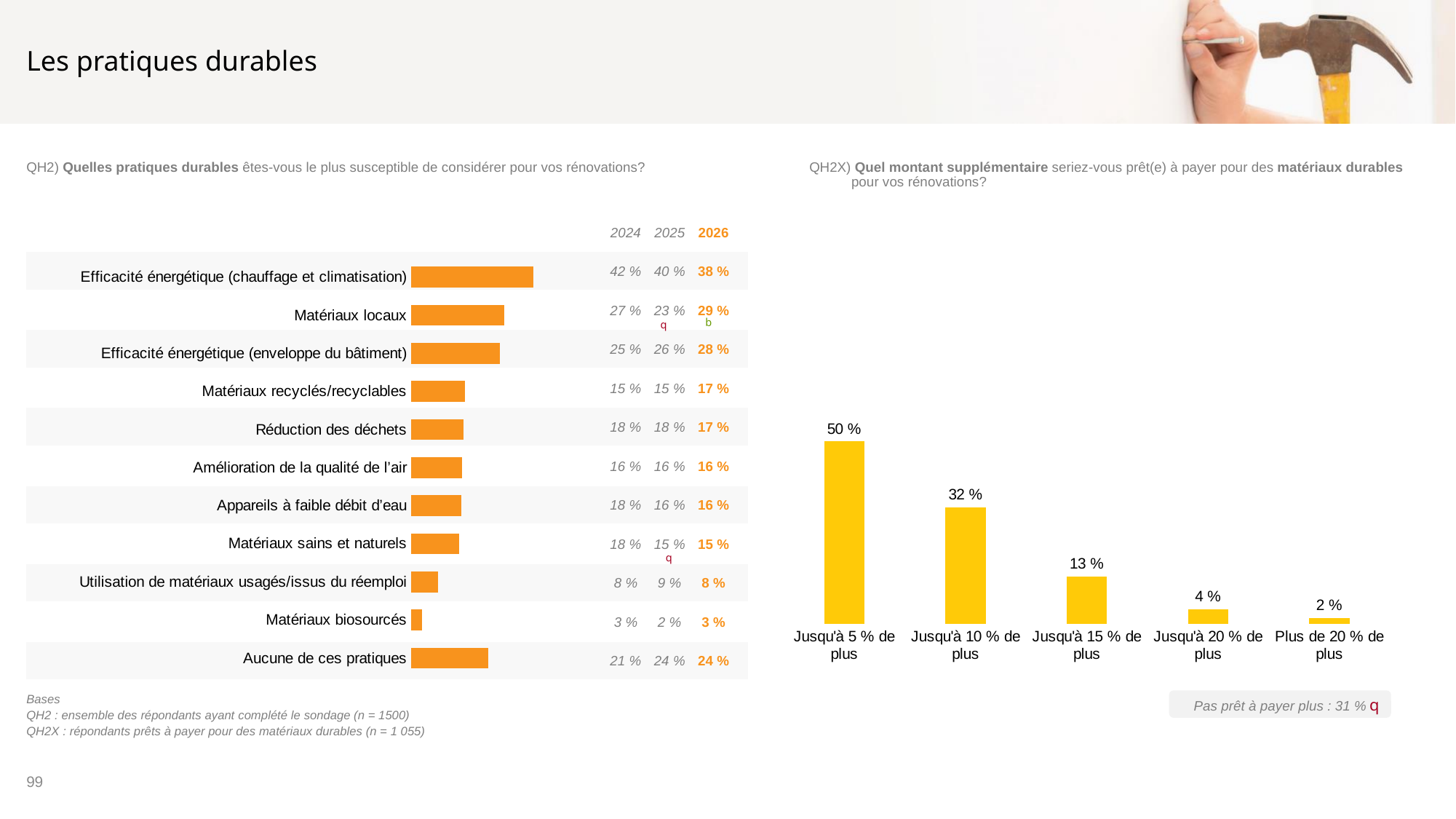
In the left chart (QH2), what is the 2026 value for Matériaux locaux? 29 % In the right chart (QH2X), what is the difference between Jusqu'à 5 % de plus and Jusqu'à 15 % de plus? 37 % In the left chart (QH2), what is the difference between the 2026 values for Efficacité énergétique (chauffage et climatisation) and Matériaux locaux? 9 % In the left chart (QH2), what was the 2024 value for Efficacité énergétique (chauffage et climatisation)? 42 % In the right chart (QH2X), do the values rise or fall from left to right? fall In the left chart (QH2), how many practices are listed? 11 In the left chart (QH2), how many years of data are shown in the table columns? 3 In the right chart (QH2X), which category has the highest value? Jusqu'à 5 % de plus What kind of chart is the right chart (QH2X)? bar chart In the right chart (QH2X), what is the value for Jusqu'à 10 % de plus? 32 % In the left chart (QH2), which practice has the lowest 2026 value? Matériaux biosourcés In the left chart (QH2), which practice has the highest 2026 value? Efficacité énergétique (chauffage et climatisation)